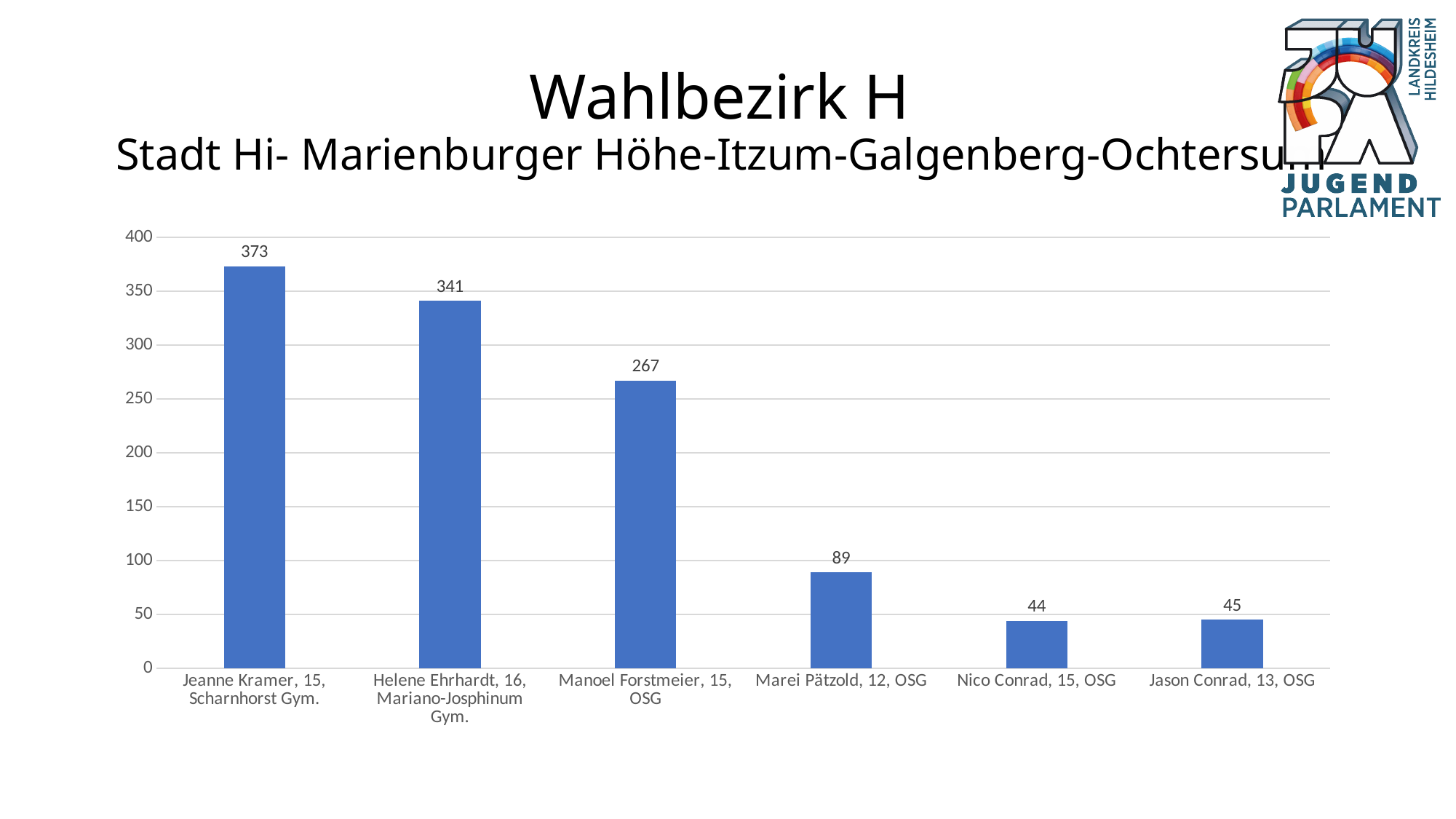
What is the value shown for Marei Pätzold? 89 What is the difference between the values for Jeanne Kramer and Helene Ehrhardt? 32 What is the title of the slide? Wahlbezirk H How many candidates are shown in the chart? 6 Who has the larger value, Helene Ehrhardt or Manoel Forstmeier? Helene Ehrhardt Which candidate has the lowest value? Nico Conrad Is the value for Helene Ehrhardt greater or less than 300? greater What is the value shown for Manoel Forstmeier? 267 What kind of chart is shown on the slide? Bar chart What is the difference between the values for Manoel Forstmeier and Marei Pätzold? 178 How many votes did Jeanne Kramer receive? 373 Which candidate has the highest value? Jeanne Kramer